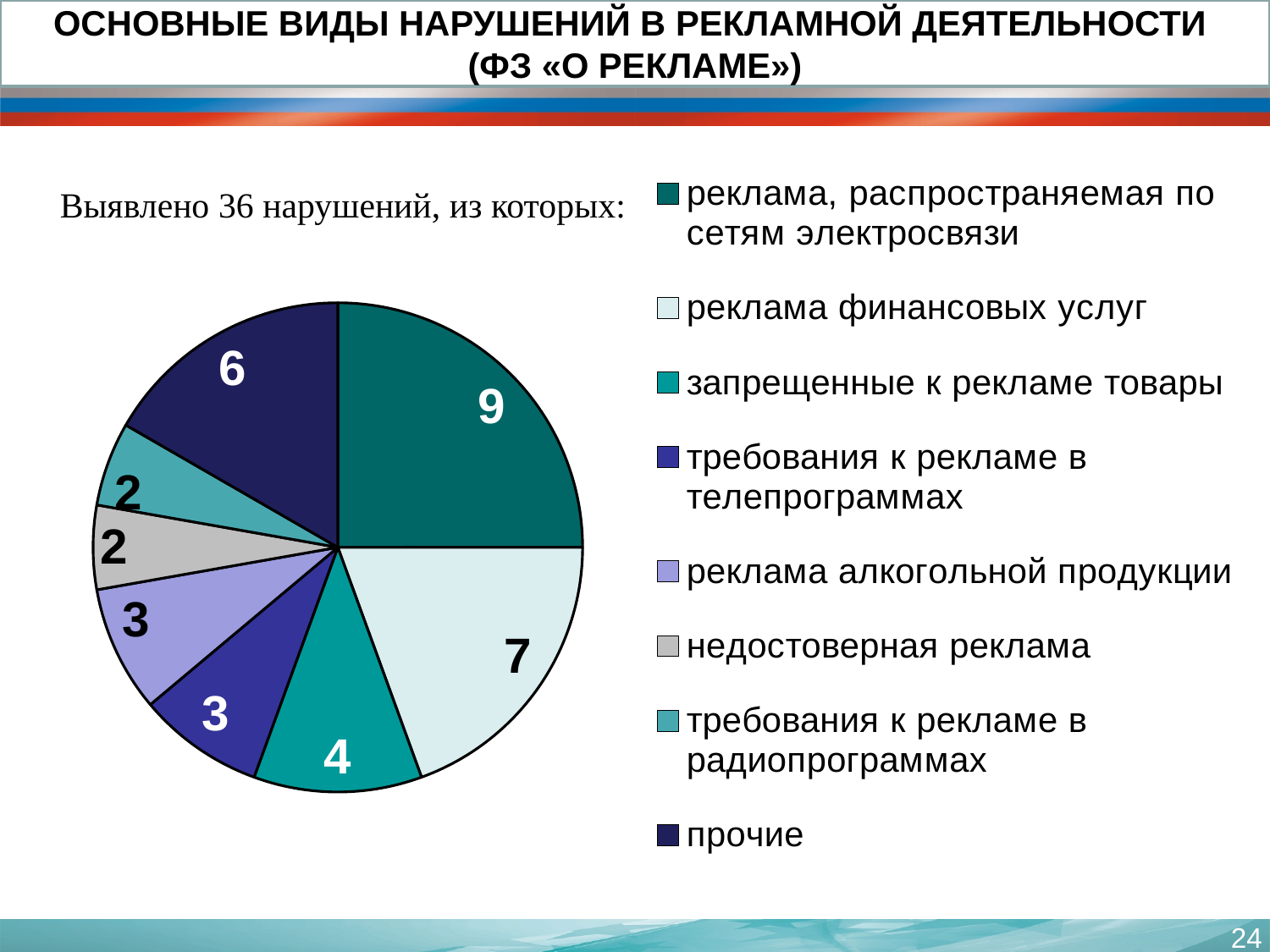
How many entries does the legend list? 8 What type of chart is shown on the slide? pie chart What is the value for «реклама финансовых услуг»? 7 What is the total of all slices in the pie chart? 36 What is the value for «прочие»? 6 What is the value for «запрещенные к рекламе товары»? 4 Which category has the largest slice of the pie? реклама, распространяемая по сетям электросвязи What is the difference between the values for «реклама, распространяемая по сетям электросвязи» and «реклама финансовых услуг»? 2 What share of the pie does the slice with value 9 represent? 25% What is the value for «реклама, распространяемая по сетям электросвязи»? 9 Which is larger: the value for «прочие» or the value for «запрещенные к рекламе товары»? прочие How many slices does the pie chart have? 8